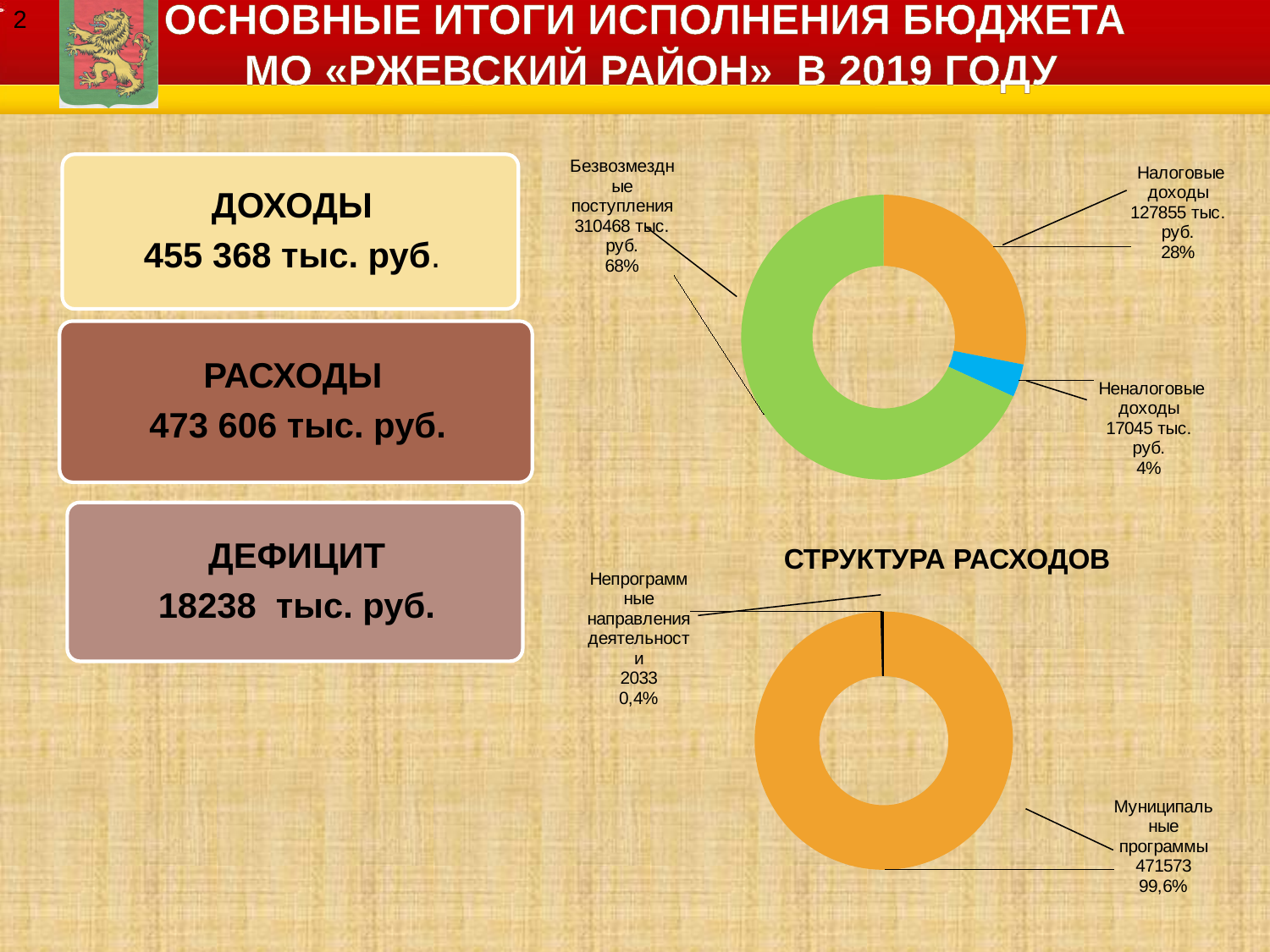
In the top-right doughnut chart, what colour is the slice for Неналоговые доходы? Blue In the top-right doughnut chart, what share of the total do Безвозмездные поступления make up? 68% What kind of chart is the chart titled СТРУКТУРА РАСХОДОВ? Doughnut (pie) chart In the chart titled СТРУКТУРА РАСХОДОВ, which is larger: Муниципальные программы or Непрограммные направления деятельности? Муниципальные программы In the top-right doughnut chart, what is the difference between Налоговые доходы and Неналоговые доходы? 110810 тыс. руб. In the chart titled СТРУКТУРА РАСХОДОВ, what share do Непрограммные направления деятельности make up? 0,4% In the top-right doughnut chart, which category has the smallest share? Неналоговые доходы In the top-right doughnut chart, how many categories are shown? 3 In the top-right doughnut chart, what is the value for Неналоговые доходы? 17045 тыс. руб. In the chart titled СТРУКТУРА РАСХОДОВ, what is the value for Муниципальные программы? 471573 In the top-right doughnut chart, which category has the largest share? Безвозмездные поступления In the top-right doughnut chart, what is the value for Налоговые доходы? 127855 тыс. руб.